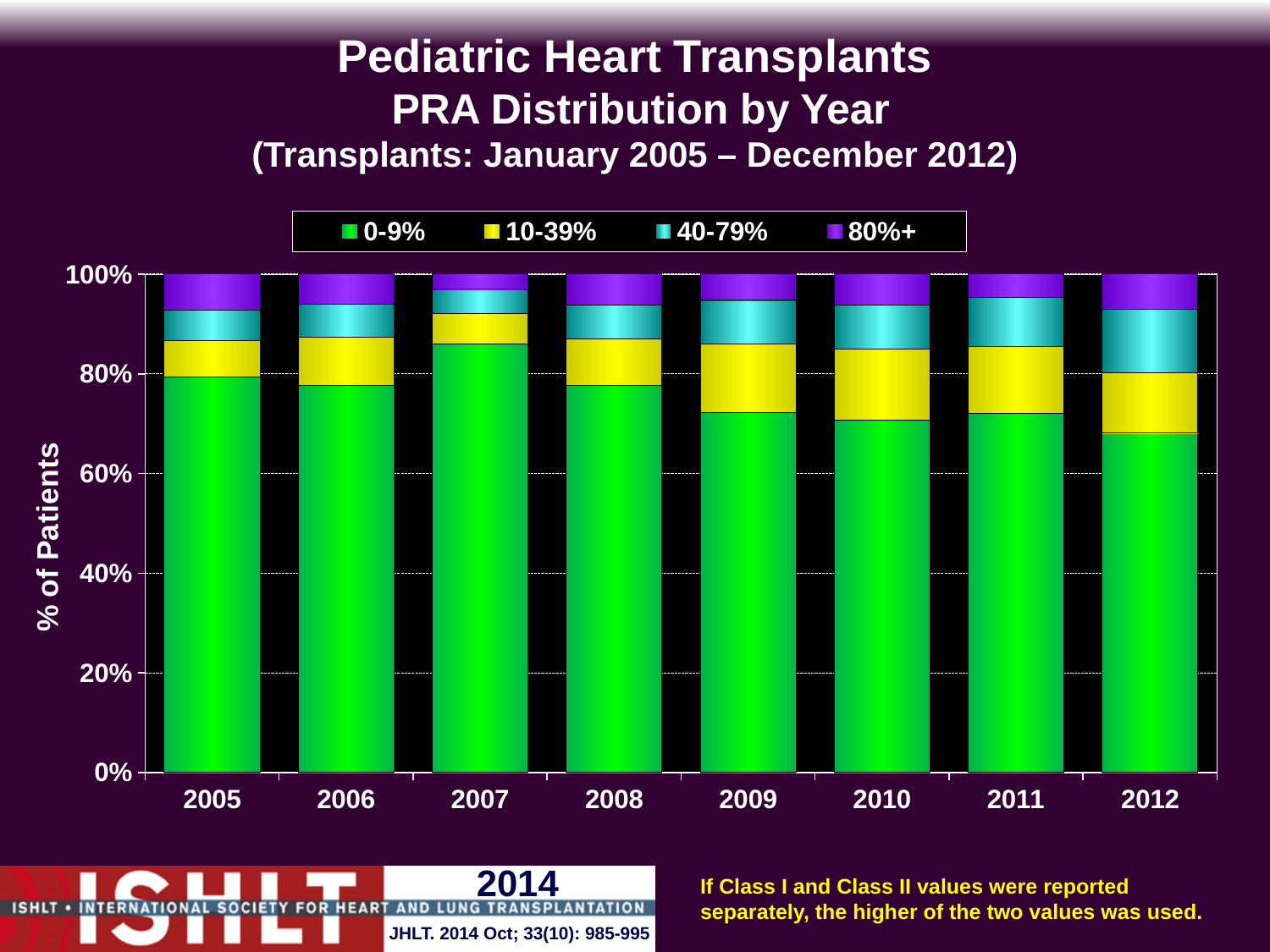
Is the 0-9% PRA share for 2009 greater or less than 80%? less What is the label on the y axis of the chart? % of Patients Which year has a larger 0-9% PRA share, 2007 or 2012? 2007 Is the 0-9% PRA share for 2012 greater or less than 80%? less Which year has the largest 0-9% PRA segment? 2007 How many years are shown along the x axis of the chart? 8 How many series does the chart legend list? 4 Which PRA categories are listed in the chart legend? 0-9%, 10-39%, 40-79%, 80%+ Is the 0-9% PRA share for 2010 greater or less than 60%? greater What kind of chart is shown on the slide? stacked bar chart What does each stacked bar in the chart total? 100%